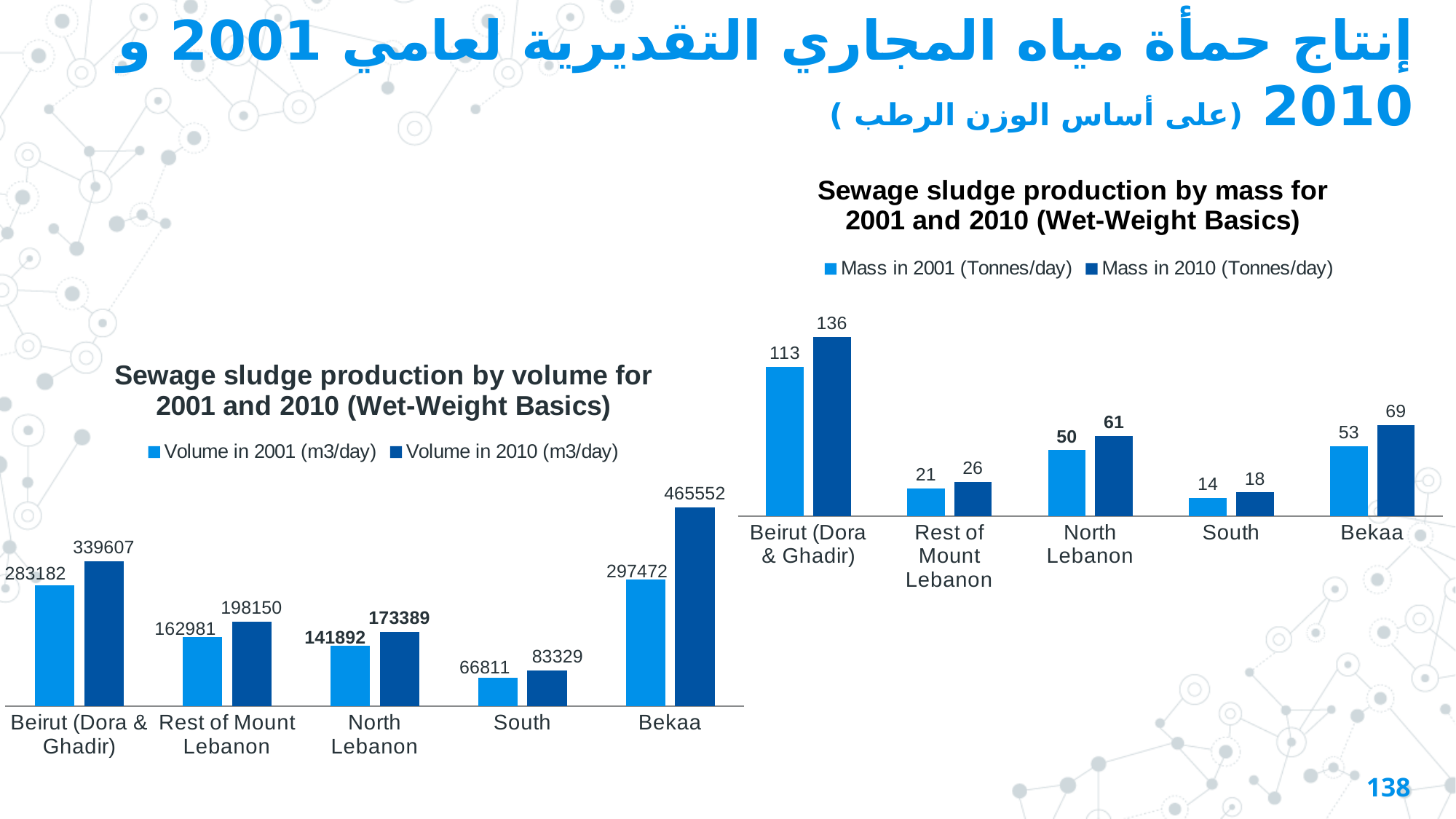
In the 'Sewage sludge production by mass' chart, what is the Mass in 2001 (Tonnes/day) for Rest of Mount Lebanon? 21 In the 'Sewage sludge production by mass' chart, what is the difference between the Mass in 2010 and the Mass in 2001 for Bekaa? 16 In the 'Sewage sludge production by volume' chart, what is the difference between the Volume in 2010 and the Volume in 2001 for Beirut (Dora & Ghadir)? 56425 How many series does the legend of the 'Sewage sludge production by volume' chart list? 2 In the 'Sewage sludge production by volume' chart, what is the Volume in 2001 (m3/day) for South? 66811 In the 'Sewage sludge production by volume' chart, what is the Volume in 2010 (m3/day) for Bekaa? 465552 In the 'Sewage sludge production by volume' chart, which region has the lowest Volume in 2010 (m3/day)? South In the 'Sewage sludge production by volume' chart, which is larger: the Volume in 2001 for Bekaa or the Volume in 2001 for Beirut (Dora & Ghadir)? Bekaa How many regions are shown on the x axis of the 'Sewage sludge production by mass' chart? 5 What kind of chart is the 'Sewage sludge production by mass' chart? Bar chart In the 'Sewage sludge production by mass' chart, which region has the highest Mass in 2001 (Tonnes/day)? Beirut (Dora & Ghadir) In the 'Sewage sludge production by mass' chart, what is the Mass in 2010 (Tonnes/day) for North Lebanon? 61